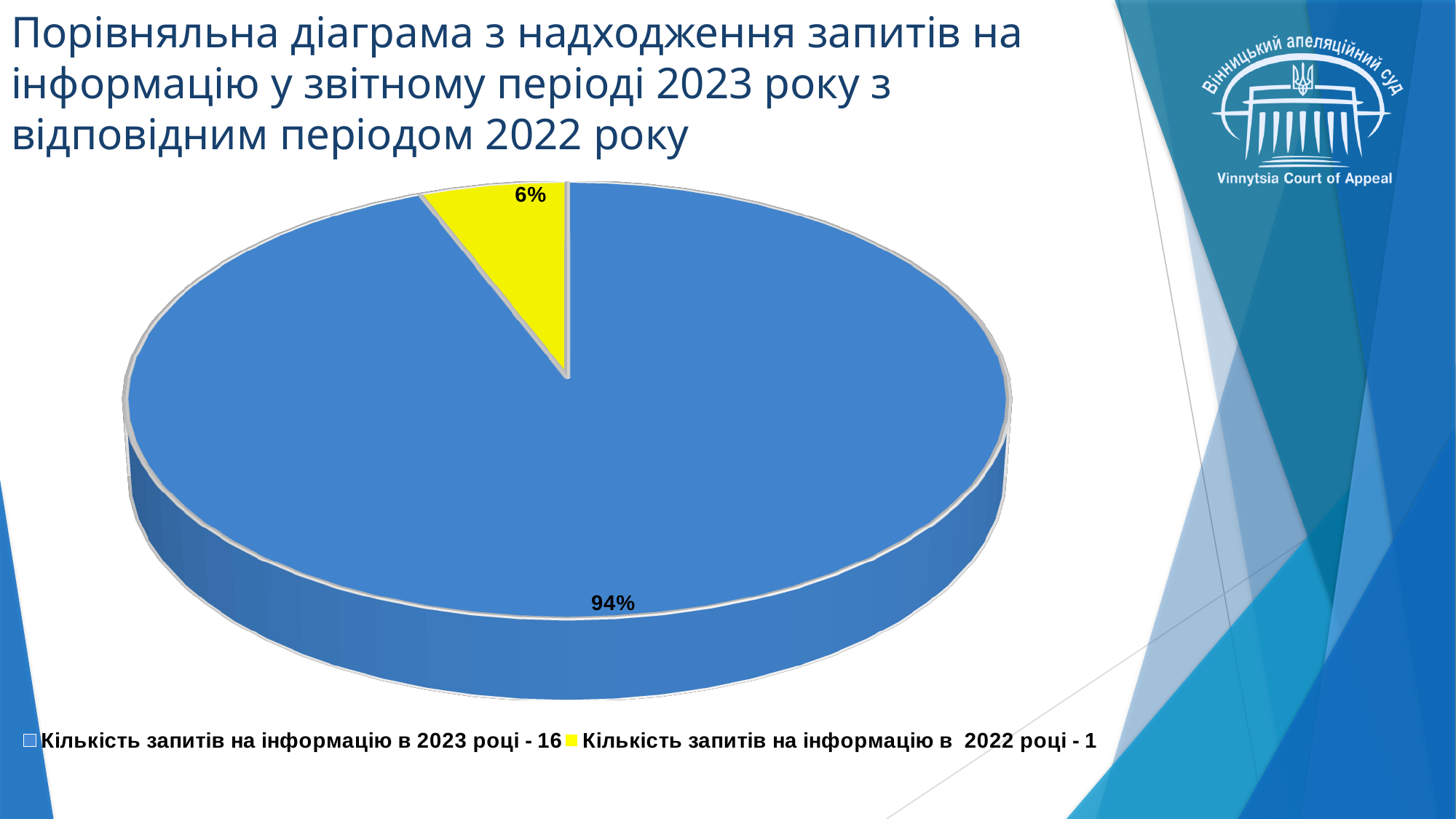
According to the legend, how many information requests were received in 2023? 16 According to the legend, how many information requests were received in 2022? 1 Which slice is the largest in the pie chart? Кількість запитів на інформацію в 2023 році - 16 How many entries does the legend list? 2 Which is larger: the share for 2023 requests or the share for 2022 requests? 2023 requests What share of the pie is the slice for 'Кількість запитів на інформацію в 2022 році - 1'? 6% What kind of chart is shown on the slide? pie chart What colour is the slice representing the 2022 requests? yellow What is the difference in percentage points between the 2023 slice and the 2022 slice? 88 What share of the pie is the slice for 'Кількість запитів на інформацію в 2023 році - 16'? 94% How many slices does the pie chart have? 2 Which slice is the smallest in the pie chart? Кількість запитів на інформацію в 2022 році - 1